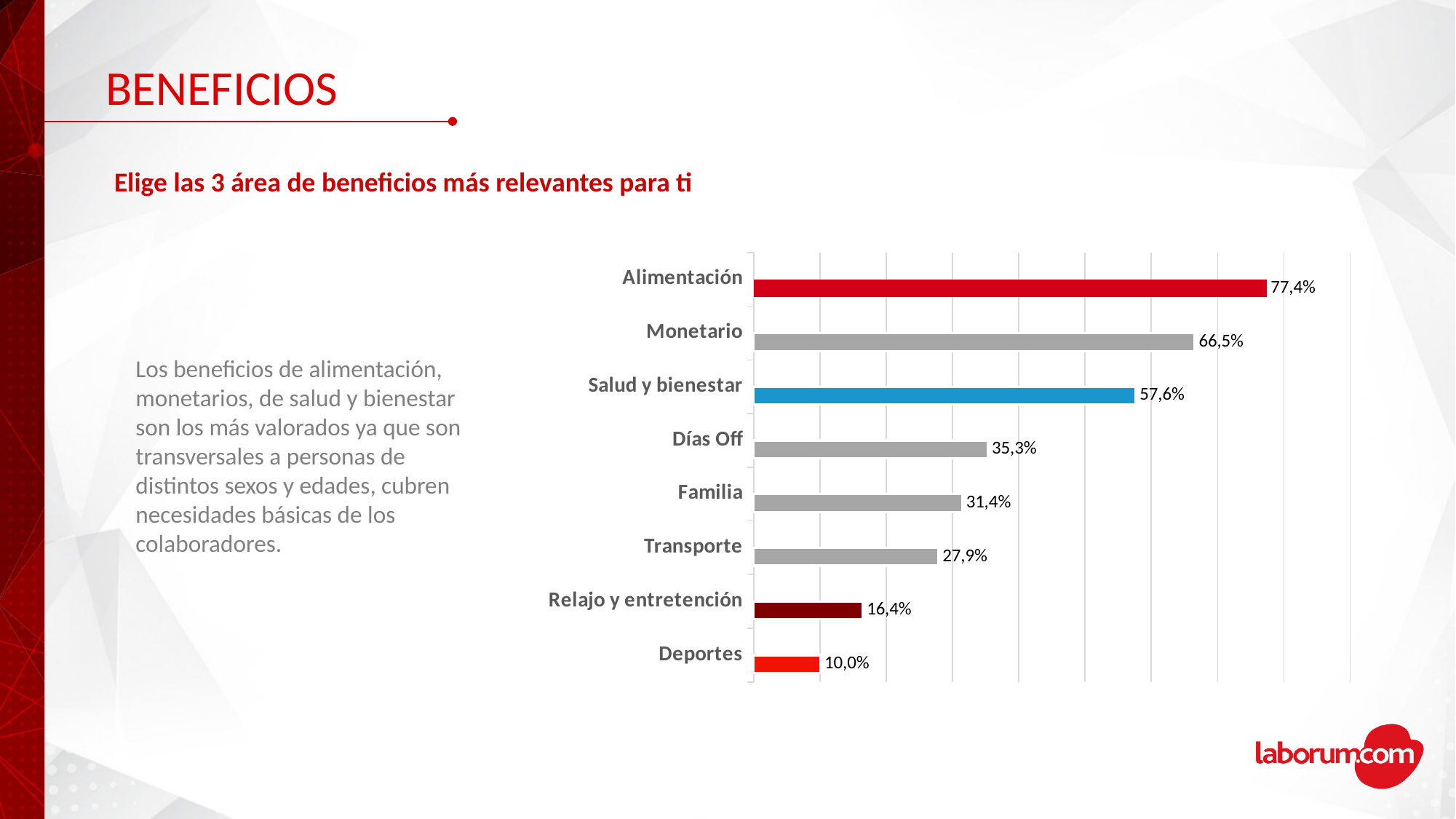
Which category has the highest value? Alimentación What is the value for Alimentación? 77,4% How many categories are shown in the chart? 8 Do the values rise or fall going from the top category to the bottom category? Fall What is the difference between the values for Alimentación and Monetario? 10,9% What is the value for Salud y bienestar? 57,6% What colour is the bar for Salud y bienestar? Blue Which is larger, the value for Familia or the value for Transporte? Familia Which category has the lowest value? Deportes What is the value for Transporte? 27,9% What is the difference between the values for Días Off and Familia? 3,9% What kind of chart is shown on the slide? Bar chart